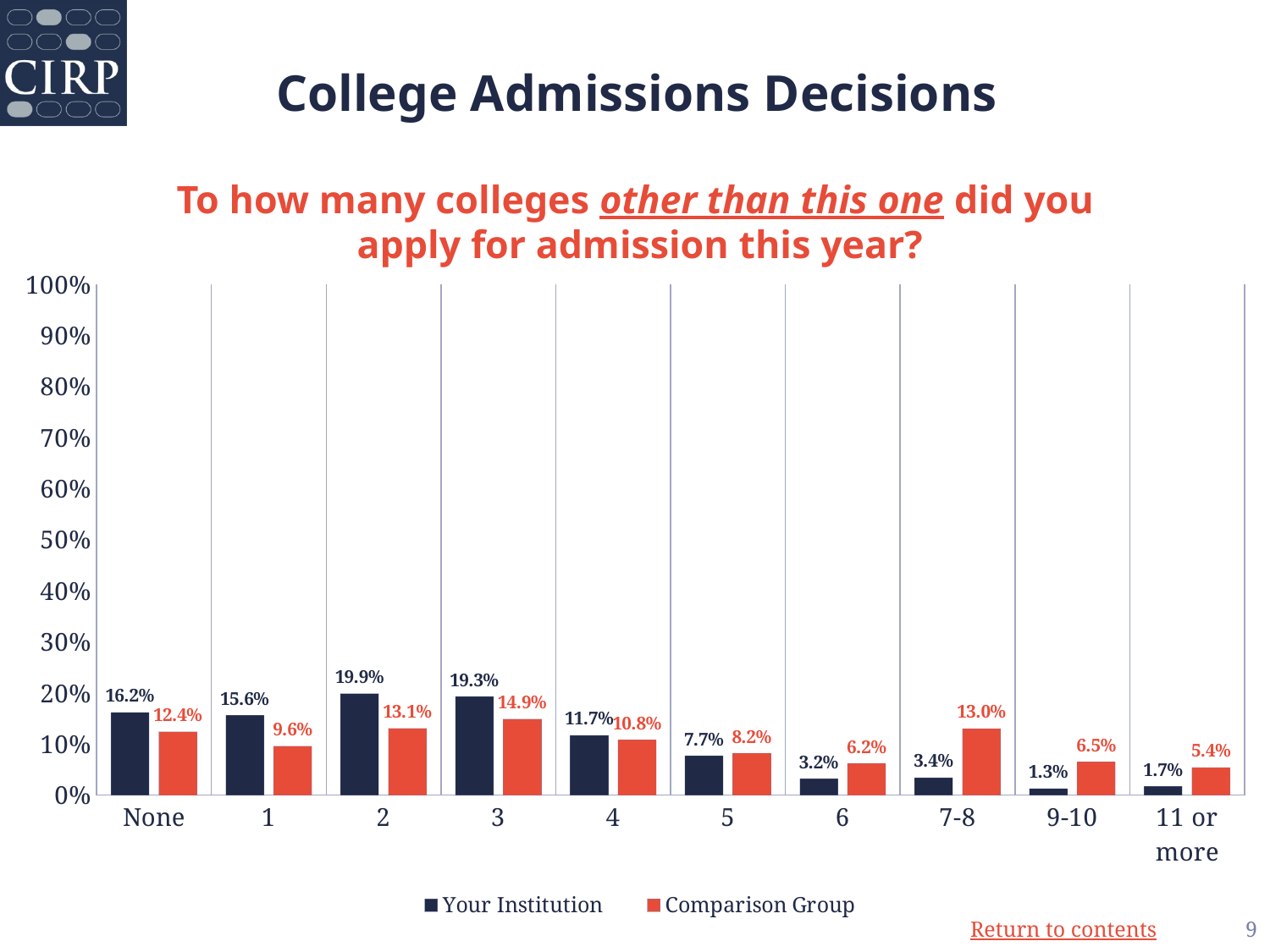
Which is larger in the '1' category: Your Institution or Comparison Group? Your Institution Which category has the lowest value for Your Institution? 9-10 What is the value for Comparison Group in the '7-8' category? 13.0% What is the difference between Your Institution and Comparison Group in the '7-8' category? 9.6% What is the value for Your Institution in the '2' category? 19.9% What is the value for Your Institution in the 'None' category? 16.2% Which category has the highest value for Comparison Group? 3 Is the value for Your Institution in the '3' category greater or less than 10%? greater How many categories are shown on the x axis? 10 What kind of chart is shown on the slide? bar chart Which category has the highest value for Your Institution? 2 How many series does the legend list? 2